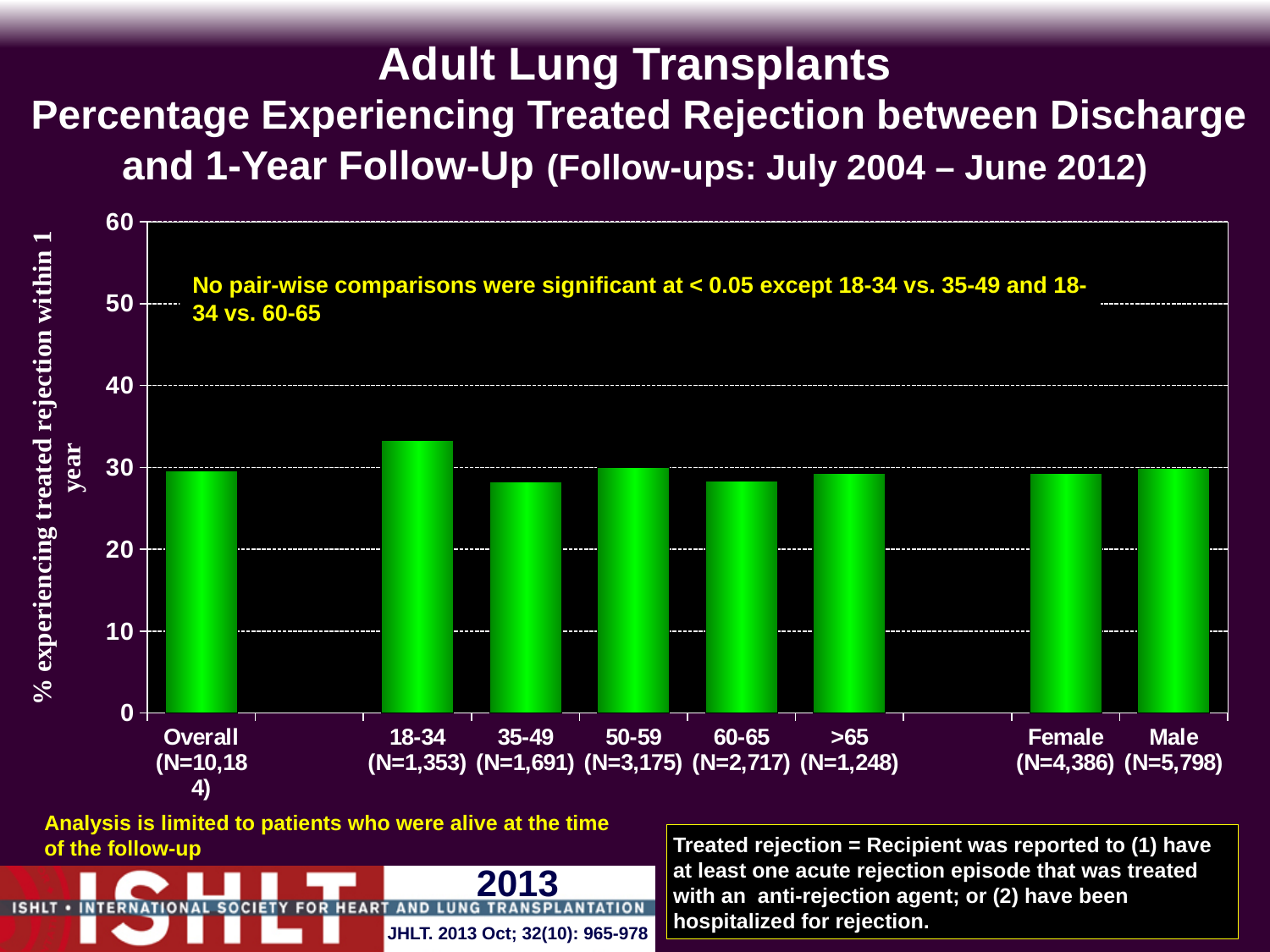
What kind of chart is shown on the slide? bar chart Is the value for the 35-49 age group greater or less than 30? less Is the value for the Male group greater or less than 40? less How many bars (categories) are plotted in the chart? 8 Is the value for the 60-65 age group greater or less than 30? less Which is larger, the value for 18-34 or the value for 60-65? 18-34 What is the sample size (N) shown for the 18-34 age group? N=1,353 What is the label on the y-axis of the chart? % experiencing treated rejection within 1 year Which category has the highest percentage experiencing treated rejection within 1 year? 18-34 Which is larger, the value for 18-34 or the value for 35-49? 18-34